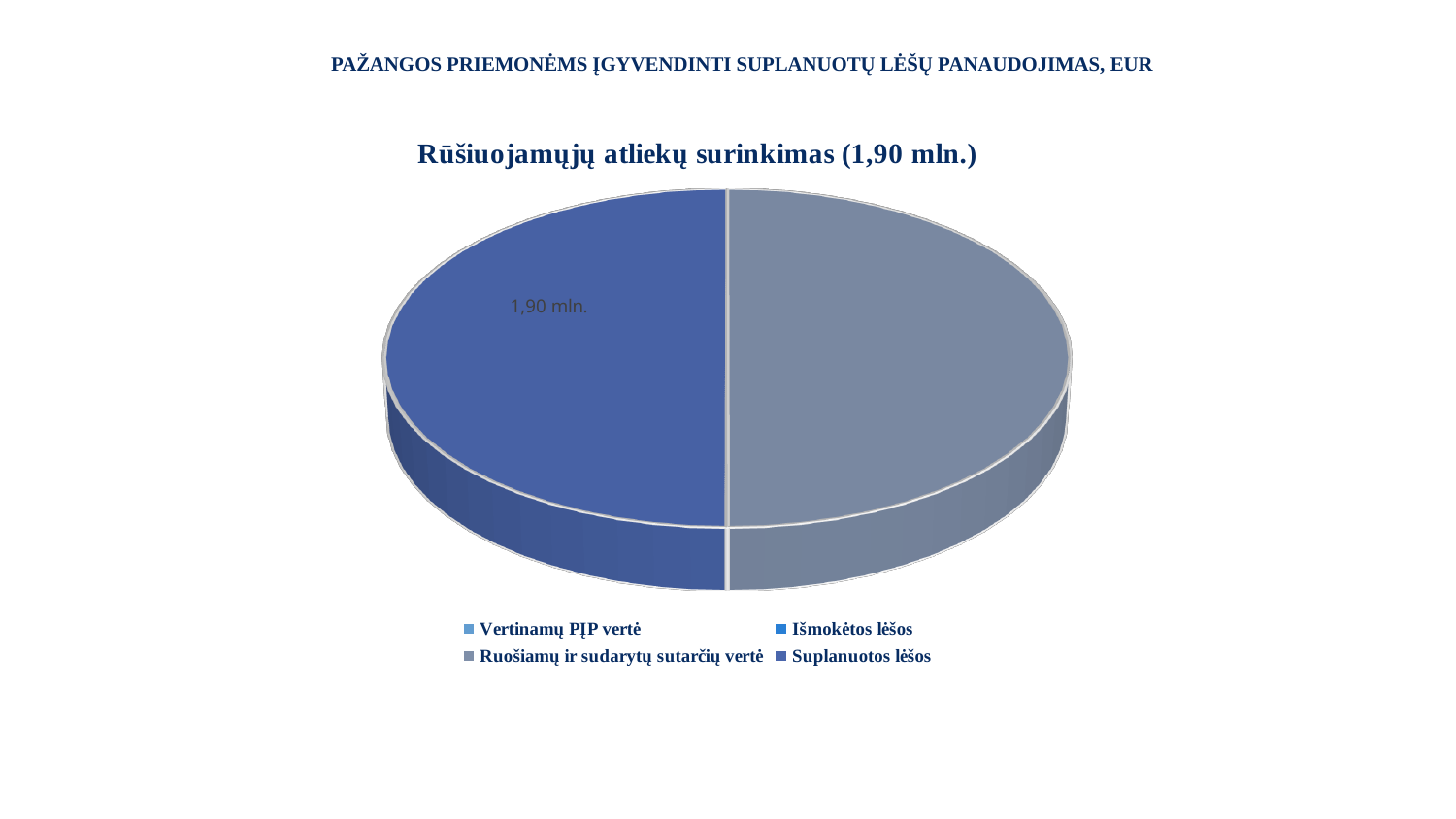
What value is printed as the data label on the blue slice of the pie? 1,90 mln. How many slices are visible in the pie chart? 2 What kind of chart is shown on the slide? pie chart What total amount is given in parentheses in the chart title? 1,90 mln. What is the title of the chart? Rūšiuojamųjų atliekų surinkimas (1,90 mln.) How many entries does the chart's legend list? 4 Which legend entry is listed first in the chart's legend? Vertinamų PĮP vertė